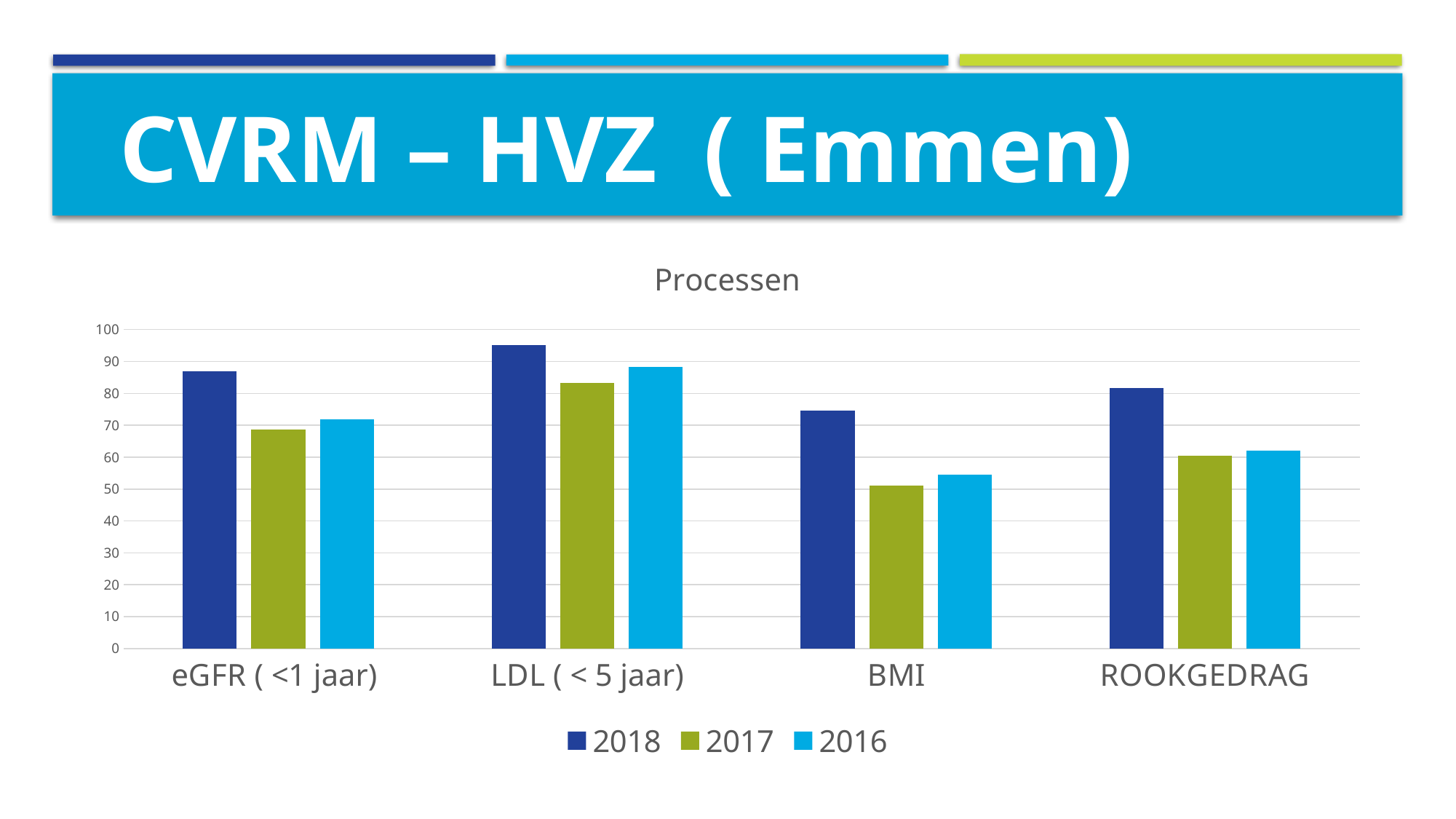
Is the 2017 value for BMI greater or less than 60? less How many categories are shown on the x axis of the "Processen" chart? 4 Which category has the highest 2018 value in the "Processen" chart? LDL ( < 5 jaar) Which series is shown in dark blue in the "Processen" chart? 2018 Which category has the lowest 2017 value in the "Processen" chart? BMI How many series does the legend of the "Processen" chart list? 3 Is the 2018 value for ROOKGEDRAG greater or less than 90? less For eGFR ( <1 jaar), which is larger: the 2018 value or the 2017 value? 2018 For LDL ( < 5 jaar), which is larger: the 2016 value or the 2017 value? 2016 Is the 2018 value for LDL ( < 5 jaar) greater or less than 90? greater What type of chart is shown under the title "Processen"? bar chart